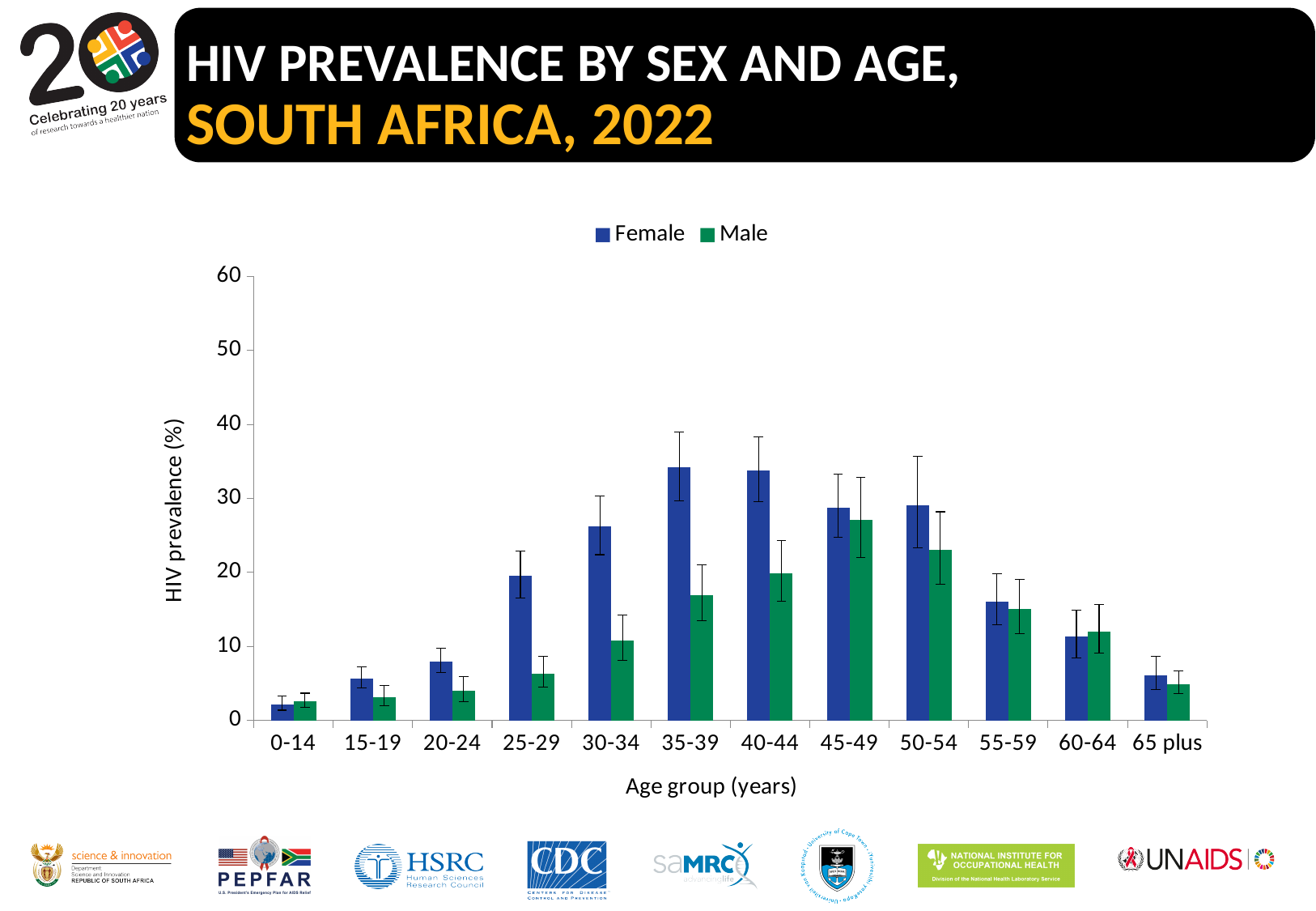
What is the label of the y axis? HIV prevalence (%) Is the male HIV prevalence for the 30-34 age group greater or less than 10? greater What kind of chart is shown on the slide? bar chart Which age group has the lowest HIV prevalence for females? 0-14 Is the female HIV prevalence for the 20-24 age group greater or less than 10? less Do the female HIV prevalence values rise or fall from the 35-39 age group to the 65 plus age group? fall Is the female HIV prevalence for the 35-39 age group greater or less than 30? greater Which age group has the highest HIV prevalence for males? 45-49 In the 40-44 age group, which is larger, the female or the male HIV prevalence? Female How many series does the legend list? 2 How many age groups are shown on the x axis? 12